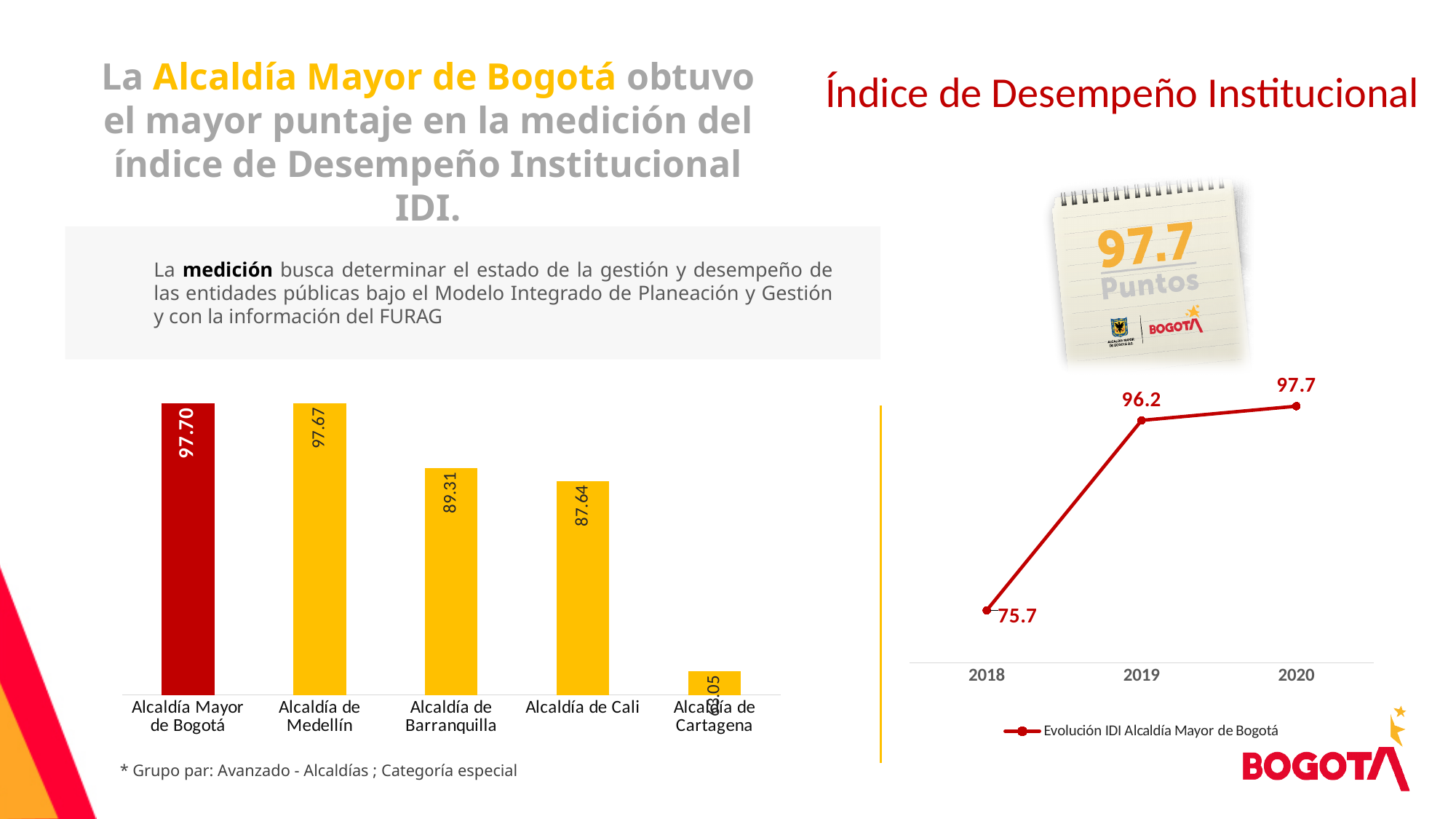
In the 'Índice de Desempeño Institucional' chart, what is the difference between the 2019 and 2018 values? 20.5 In the 'Índice de Desempeño Institucional' chart, what is the value for 2019? 96.2 In the bar chart on the left, what is the value for Alcaldía de Cali? 87.64 In the bar chart on the left, which category has the highest value? Alcaldía Mayor de Bogotá In the bar chart on the left, what is the difference between the values for Alcaldía de Barranquilla and Alcaldía de Cali? 1.67 In the bar chart on the left, what is the value for Alcaldía de Medellín? 97.67 In the 'Índice de Desempeño Institucional' chart, what is the value for 2018? 75.7 What kind of chart is the chart on the left of the slide? Bar chart In the bar chart on the left, which category has the lowest value? Alcaldía de Cartagena In the bar chart on the left, what is the value for Alcaldía de Barranquilla? 89.31 In the 'Índice de Desempeño Institucional' chart, do the values rise or fall from 2018 to 2020? Rise In the bar chart on the left, how many categories are shown? 5